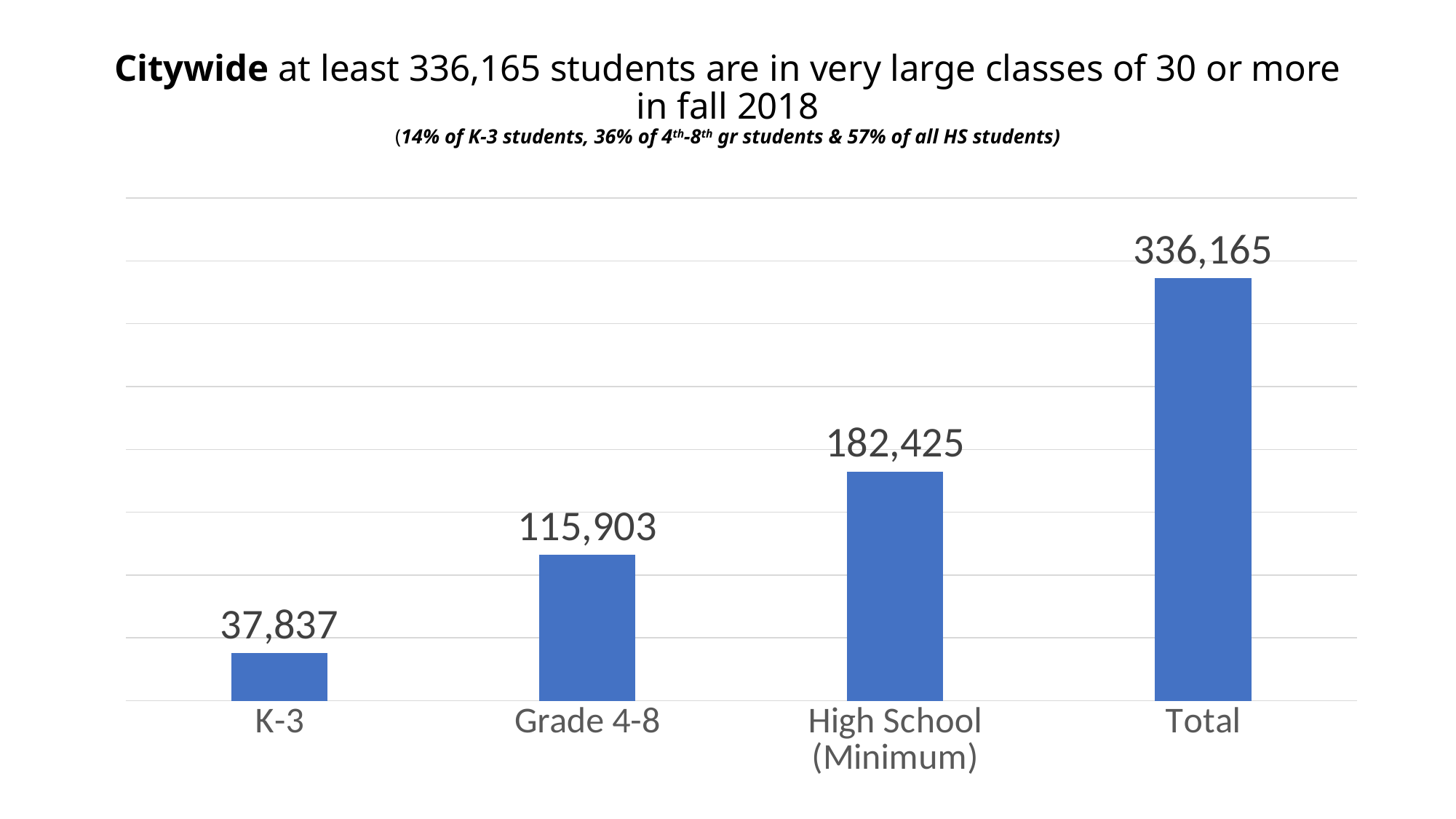
What is the difference between the High School (Minimum) value and the Grade 4-8 value? 66,522 What kind of chart is shown on the slide? Bar chart What is the value for Grade 4-8? 115,903 What is the value for K-3? 37,837 Which category has the highest value? Total How many categories are shown on the x axis? 4 Which is larger, the value for Grade 4-8 or the value for High School (Minimum)? High School (Minimum) Which category has the lowest value? K-3 What is the value for High School (Minimum)? 182,425 What is the difference between the Grade 4-8 value and the K-3 value? 78,066 What is the value for Total? 336,165 Do the values rise or fall from left to right along the x axis? Rise